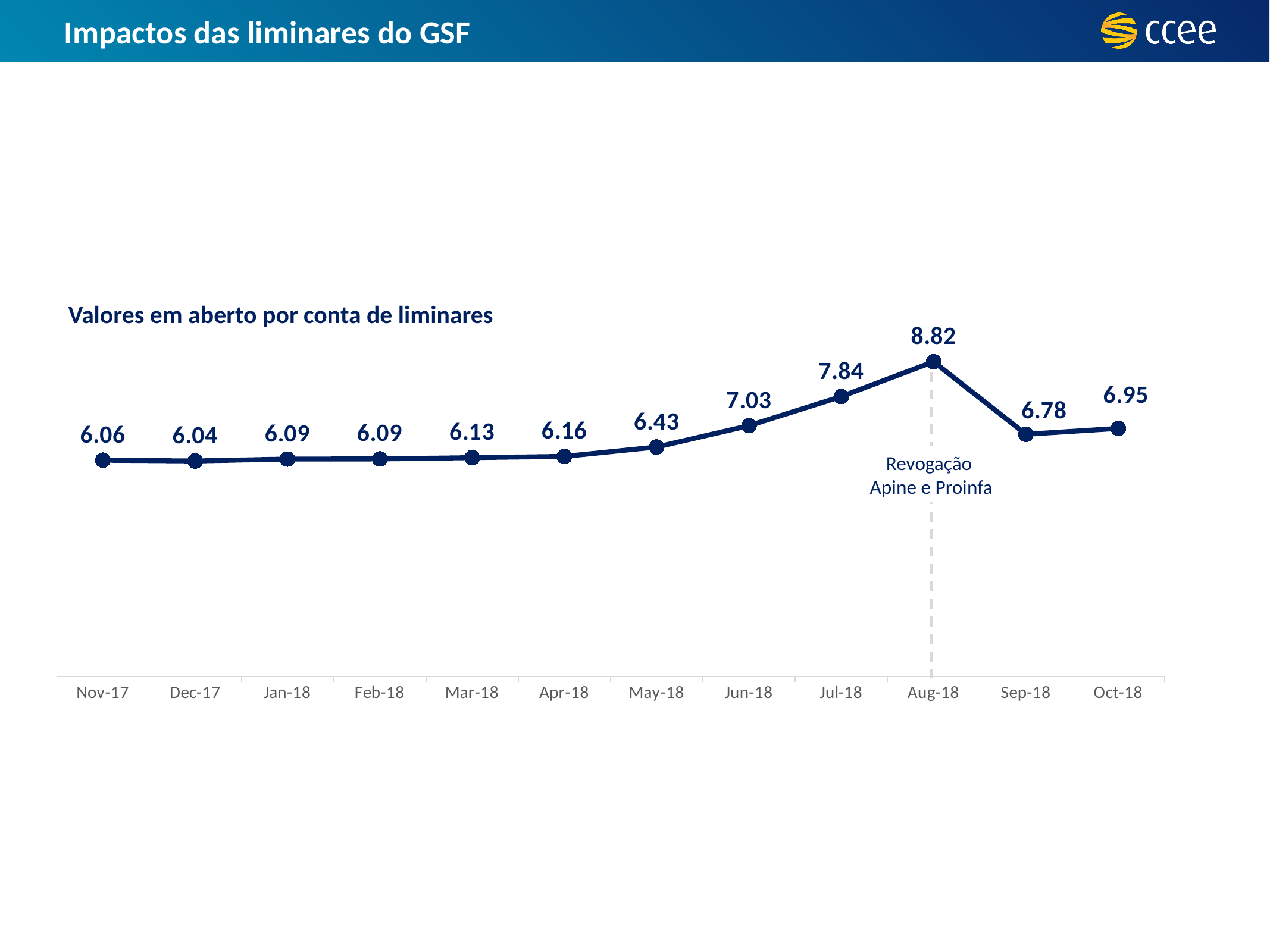
What is the value for Aug-18? 8.82 What is the title of the chart? Valores em aberto por conta de liminares What is the difference between the values for Aug-18 and Sep-18? 2.04 Which is larger, the value for May-18 or the value for Oct-18? Oct-18 What is the value for Oct-18? 6.95 Which month has the highest value? Aug-18 Which month has the lowest value? Dec-17 Do the values rise or fall from Nov-17 to Aug-18? Rise What is the difference between the values for Jul-18 and Jun-18? 0.81 What kind of chart is shown on the slide? Line chart What is the value for Nov-17? 6.06 How many data points are plotted on the chart? 12